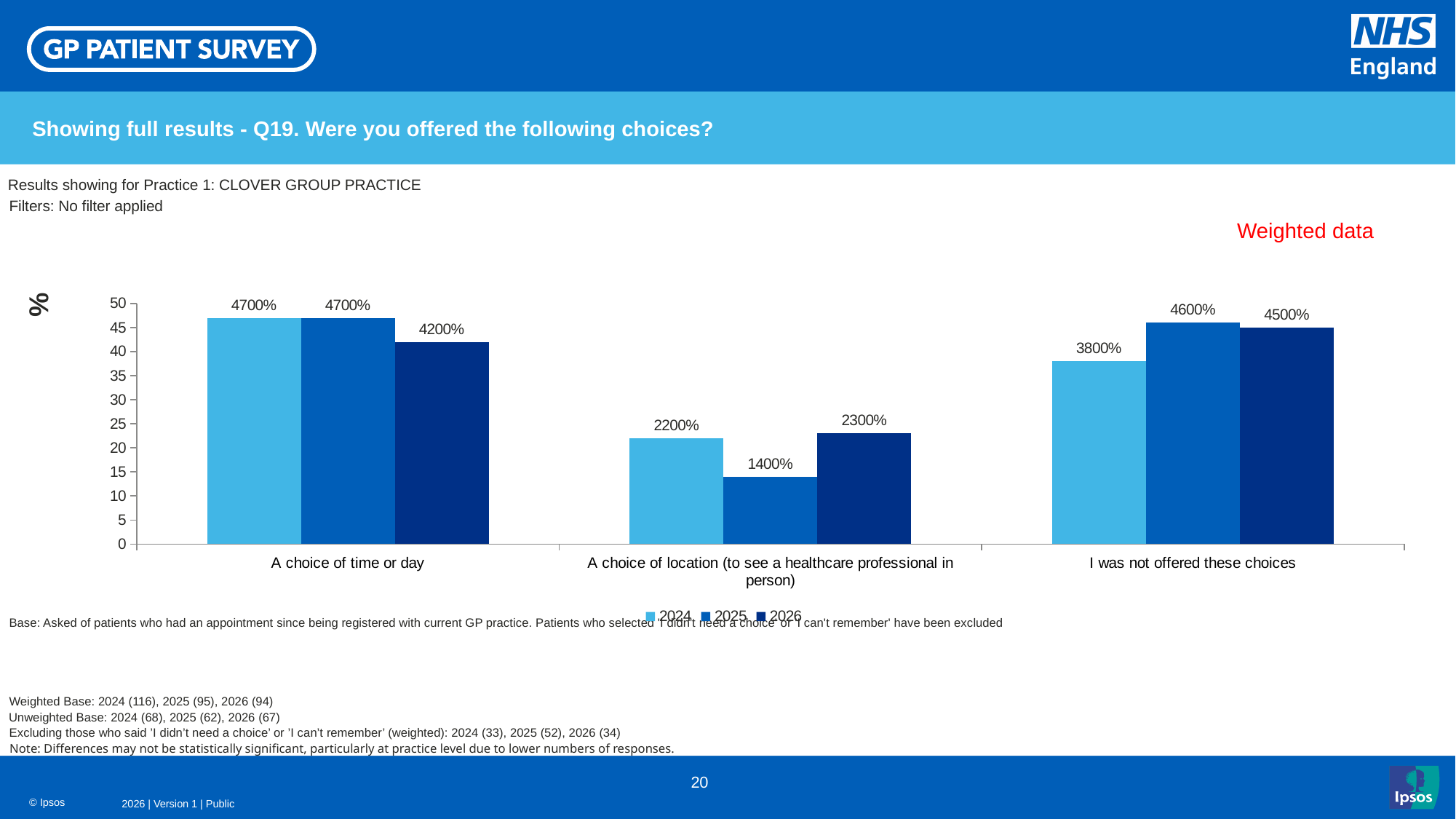
Which category has the lowest value for the 2025 series? A choice of location (to see a healthcare professional in person) Which is larger for 'A choice of location (to see a healthcare professional in person)': the 2024 value or the 2026 value? 2026 Does the value for 'A choice of time or day' rise or fall from 2025 to 2026? fall What is the value for 2024 for 'I was not offered these choices'? 3800% How many series does the legend list? 3 What is the value for 2026 for 'A choice of time or day'? 4200% Which year has the highest value for 'I was not offered these choices'? 2025 What label is shown on the vertical axis of the chart? % How many categories are shown on the x axis? 3 What is the difference between the 2024 and 2025 values for 'I was not offered these choices'? 800% What type of chart is shown on the slide? bar chart What is the value for 2025 for 'A choice of location (to see a healthcare professional in person)'? 1400%